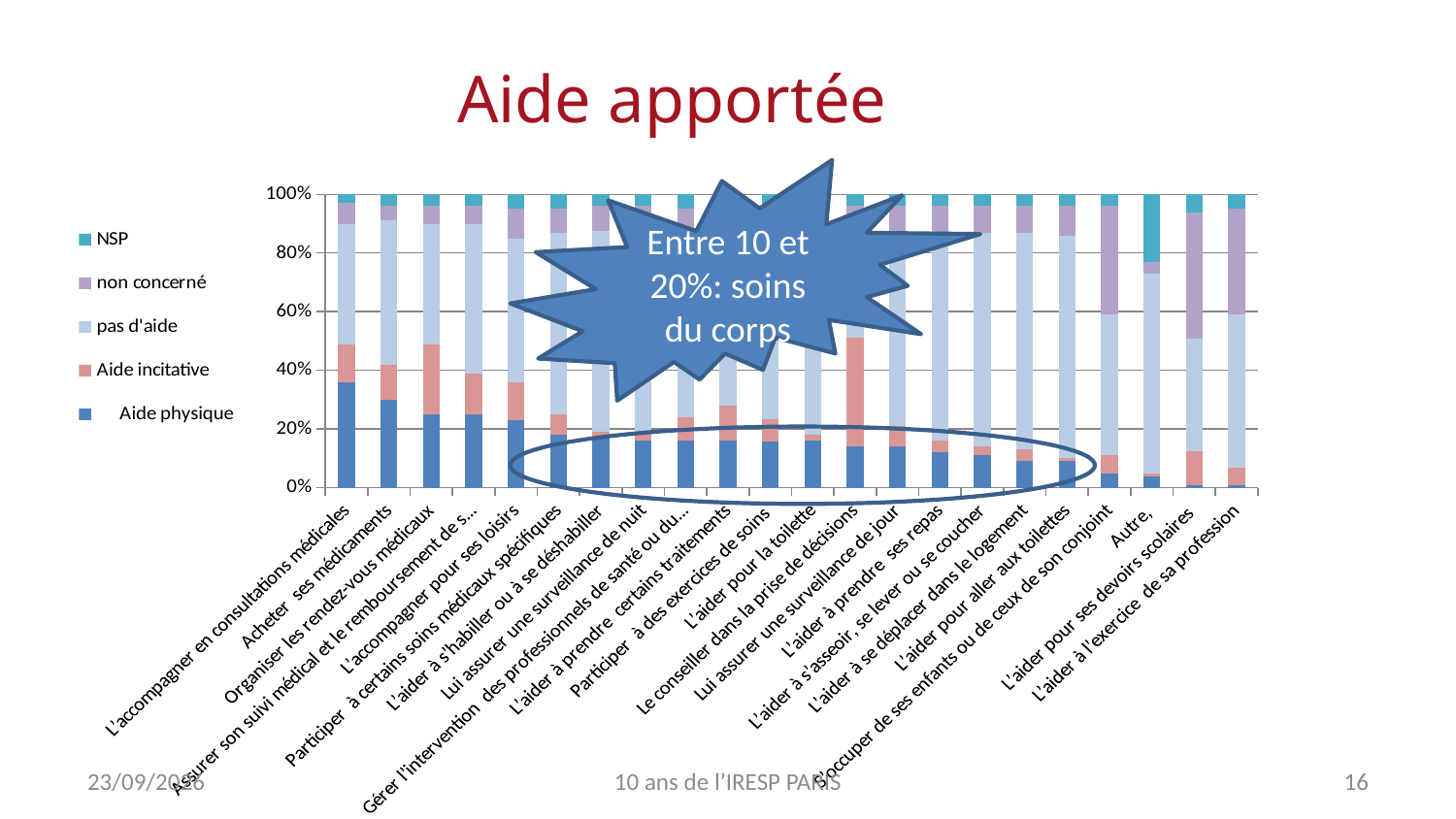
Is the Aide physique value for L'accompagner en consultations médicales greater or less than 20%? greater Does the Aide physique value generally rise or fall from left to right across the categories? fall How many series does the legend list? 5 Which category has the highest value for Aide physique? L'accompagner en consultations médicales What text is written in the star-shaped callout over the chart? Entre 10 et 20%: soins du corps What kind of chart is shown on the slide? Stacked bar chart How many categories are plotted along the x axis? 22 Is the Aide physique value for L'aider pour ses devoirs scolaires greater or less than 20%? less What is the title of the chart? Aide apportée Is the non concerné value for L'aider à l'exercice de sa profession greater or less than 20%? greater Which has the larger Aide physique value: Acheter ses médicaments or L'aider pour la toilette? Acheter ses médicaments